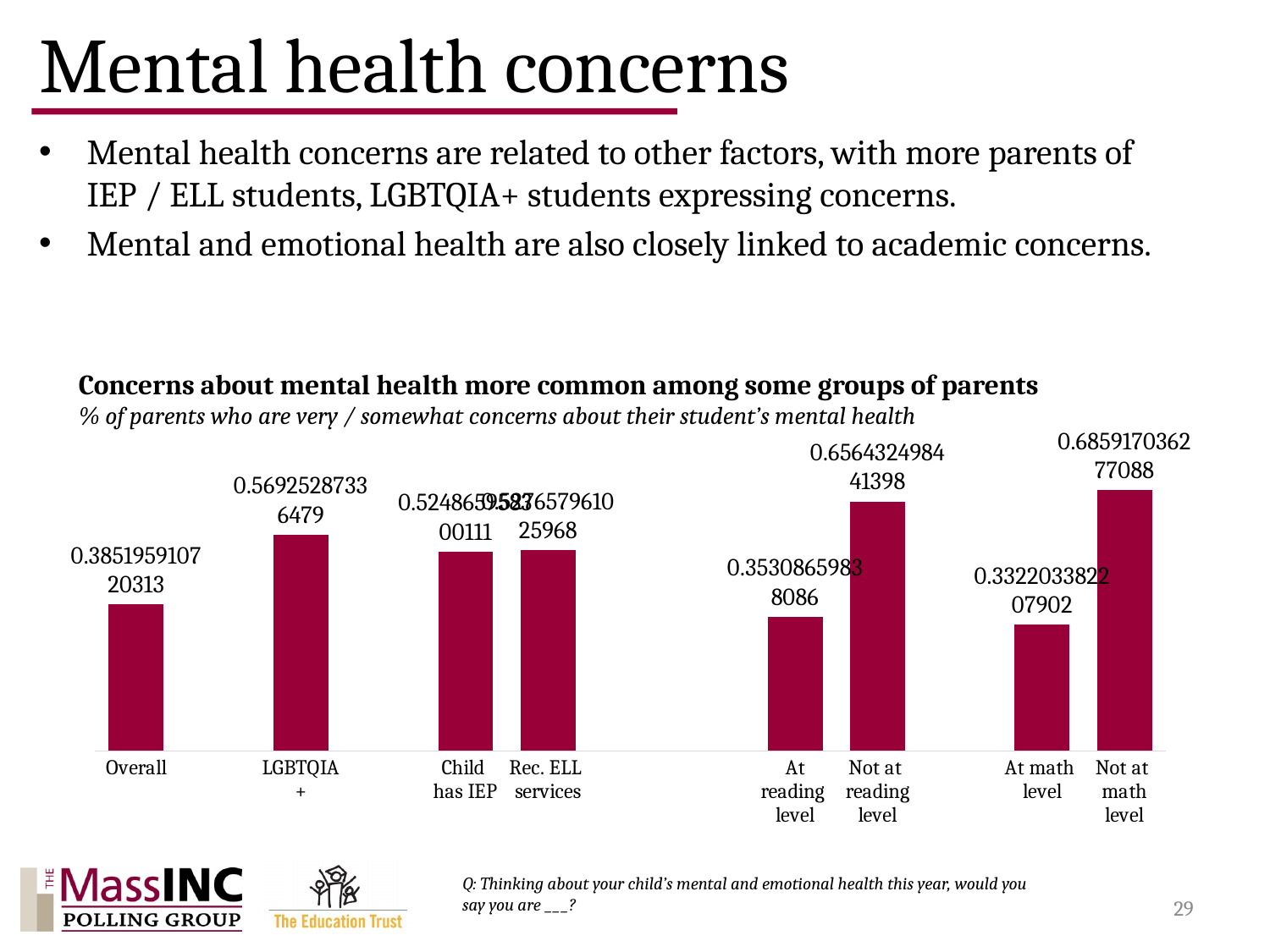
What is the value for Not at reading level in the chart? 0.656432498441398 What is the value for Not at math level in the chart? 0.685917036277088 What is the value for LGBTQIA+ in the chart? 0.56925287336479 What is the title of the chart? Concerns about mental health more common among some groups of parents What is the value for Overall in the chart? 0.385195910720313 Which is larger, the value for Overall or LGBTQIA+? LGBTQIA+ How many bars are shown in the chart? 8 What is the value for At math level in the chart? 0.332203382207902 Which category has the highest value in the chart? Not at math level What kind of chart is shown on the slide? Bar chart Which is larger, the value for At reading level or Not at reading level? Not at reading level Which category has the lowest value in the chart? At math level